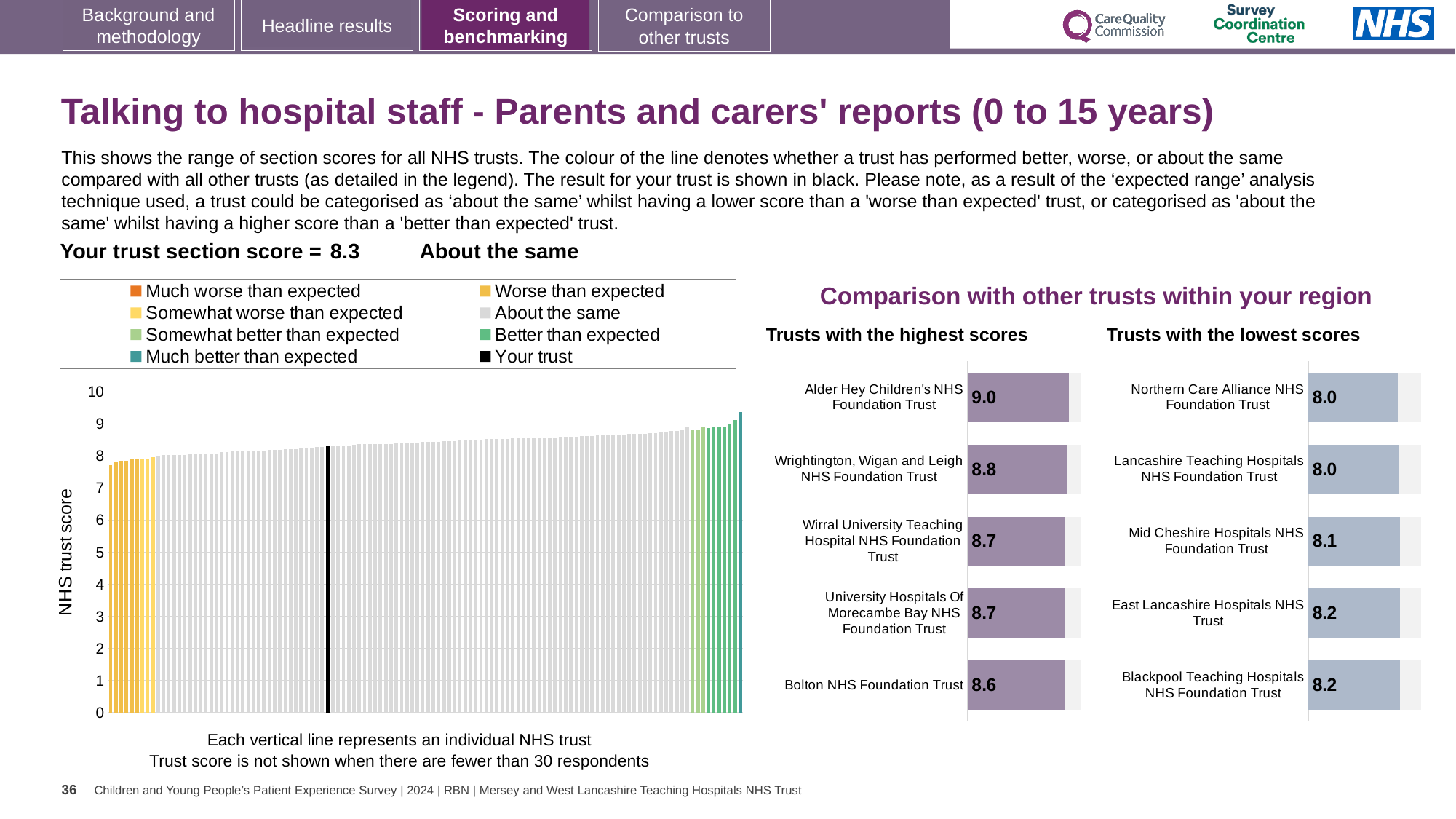
In the 'Trusts with the highest scores' chart, what is the score for Alder Hey Children's NHS Foundation Trust? 9.0 In the 'Trusts with the highest scores' chart, what is the score for Bolton NHS Foundation Trust? 8.6 What kind of chart is the main 'NHS trust score' chart on the left? Bar chart How many trusts are shown in the 'Trusts with the lowest scores' chart? 5 In the main 'NHS trust score' chart on the left, is the value for the black 'Your trust' bar greater or less than 5? greater How many entries does the legend of the main 'NHS trust score' chart on the left list? 8 In the main 'NHS trust score' chart on the left, do the bar values rise or fall from left to right? rise In the 'Trusts with the lowest scores' chart, what is the score for Mid Cheshire Hospitals NHS Foundation Trust? 8.1 In the 'Trusts with the lowest scores' chart, what is the difference between the scores of Blackpool Teaching Hospitals NHS Foundation Trust and Northern Care Alliance NHS Foundation Trust? 0.2 In the 'Trusts with the highest scores' chart, which trust has the highest score? Alder Hey Children's NHS Foundation Trust In the 'Trusts with the highest scores' chart, what is the difference between the scores of Alder Hey Children's NHS Foundation Trust and Bolton NHS Foundation Trust? 0.4 In the 'Trusts with the highest scores' chart, which has the larger score: Wrightington, Wigan and Leigh NHS Foundation Trust or Wirral University Teaching Hospital NHS Foundation Trust? Wrightington, Wigan and Leigh NHS Foundation Trust